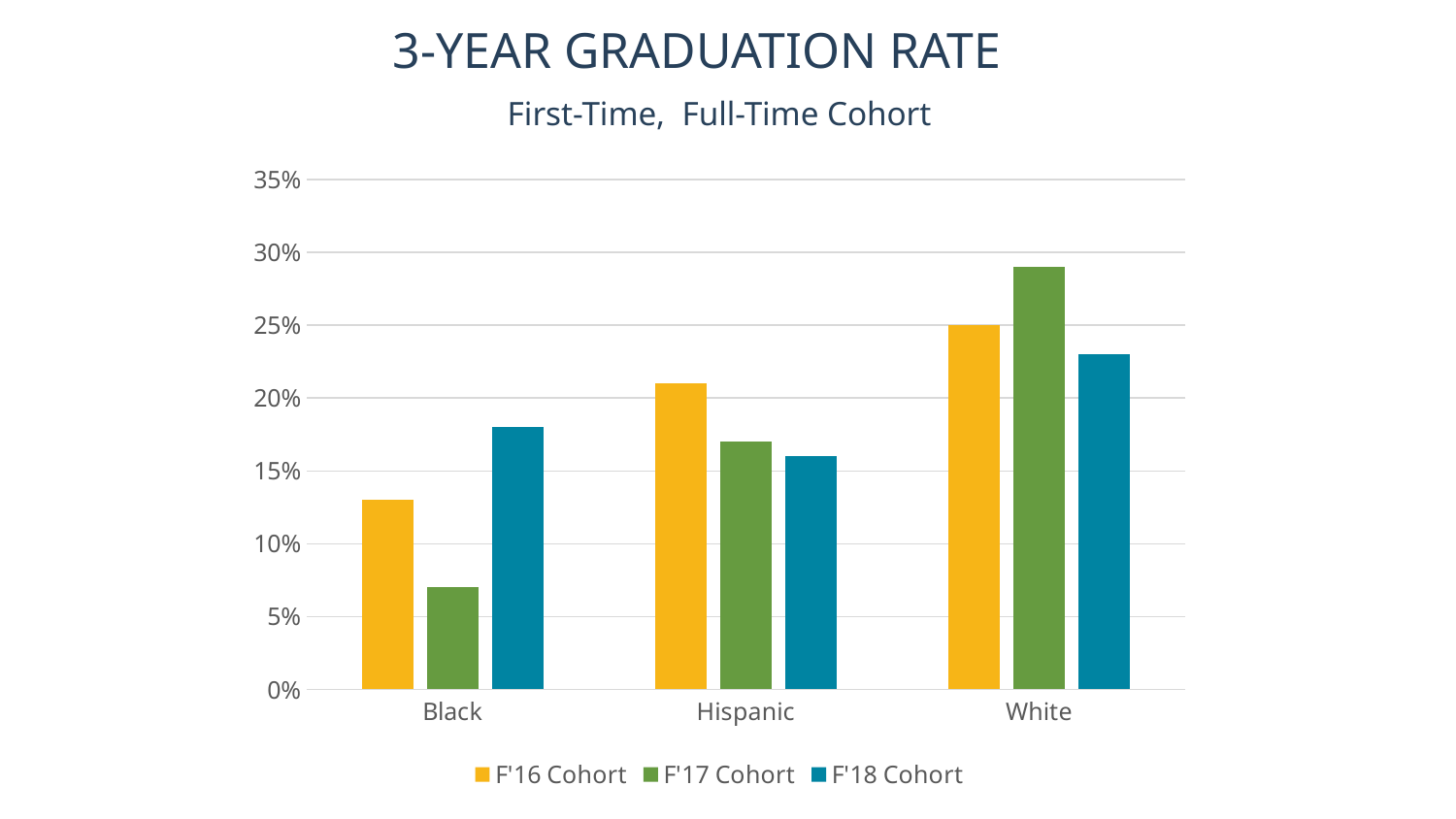
Is the F'17 Cohort value for Black greater or less than 10%? less What kind of chart is shown on the slide? bar chart Which category has the lowest F'17 Cohort graduation rate? Black For the Hispanic category, which is larger: the F'16 Cohort or the F'17 Cohort value? F'16 Cohort How many categories are shown on the x axis? 3 What is the subtitle of the chart? First-Time, Full-Time Cohort How many series does the legend list? 3 Is the F'16 Cohort value for Hispanic greater or less than 20%? greater Which category has the lowest F'16 Cohort graduation rate? Black Is the F'18 Cohort value for Black greater or less than 15%? greater Which category has the highest F'17 Cohort graduation rate? White